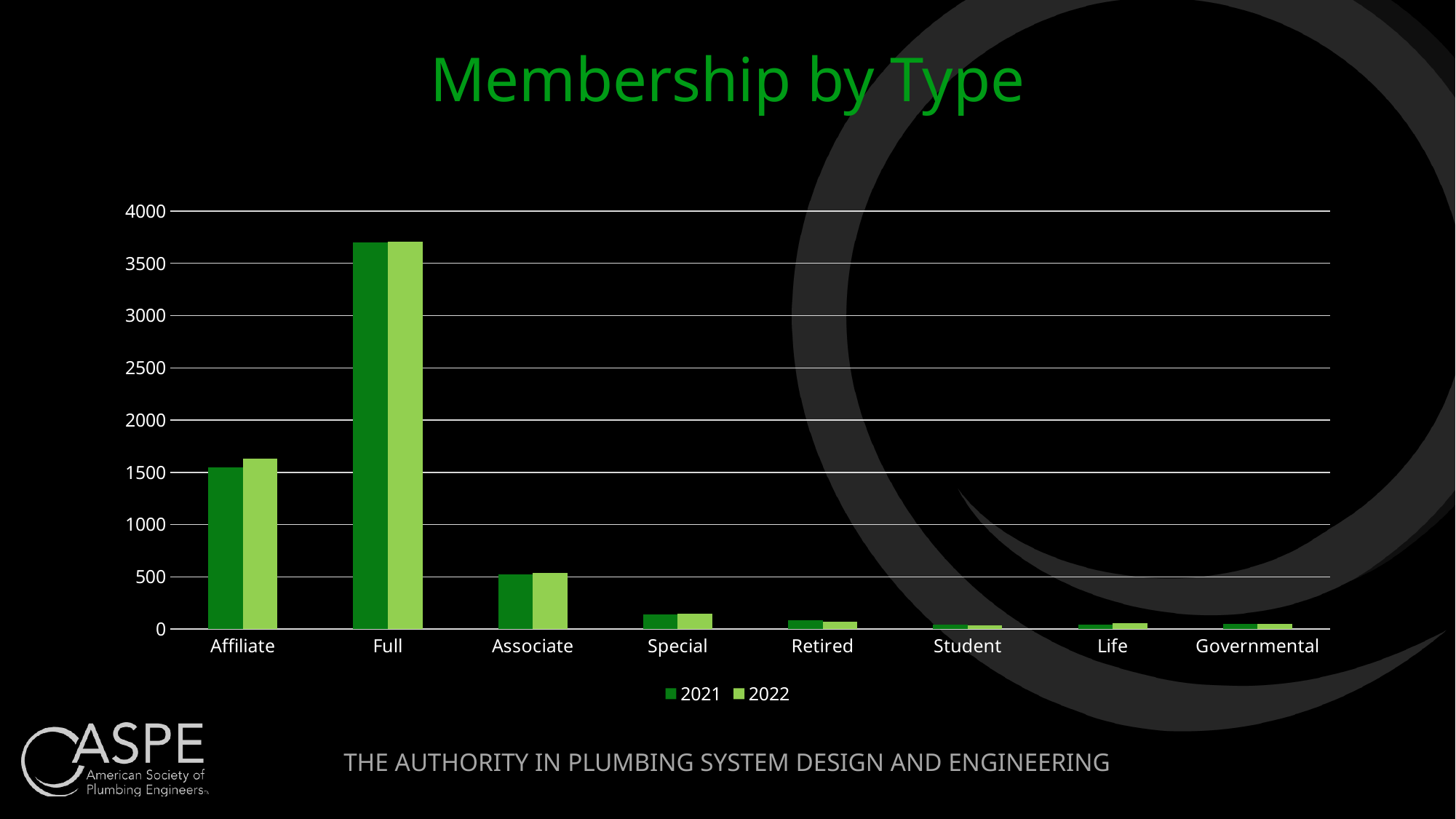
Which is larger in 2022, Associate or Special? Associate Is the 2021 value for Full greater or less than 3500? greater Is the 2021 value for Associate greater or less than 1000? less Is the 2022 value for Full greater or less than 4000? less Which is larger for Affiliate, the 2021 value or the 2022 value? 2022 What is the title of the chart? Membership by Type How many membership types are shown on the x axis? 8 What kind of chart is shown on the slide? bar chart How many series does the legend list? 2 Which membership type has the highest value in 2021? Full Which membership type has the highest value in 2022? Full